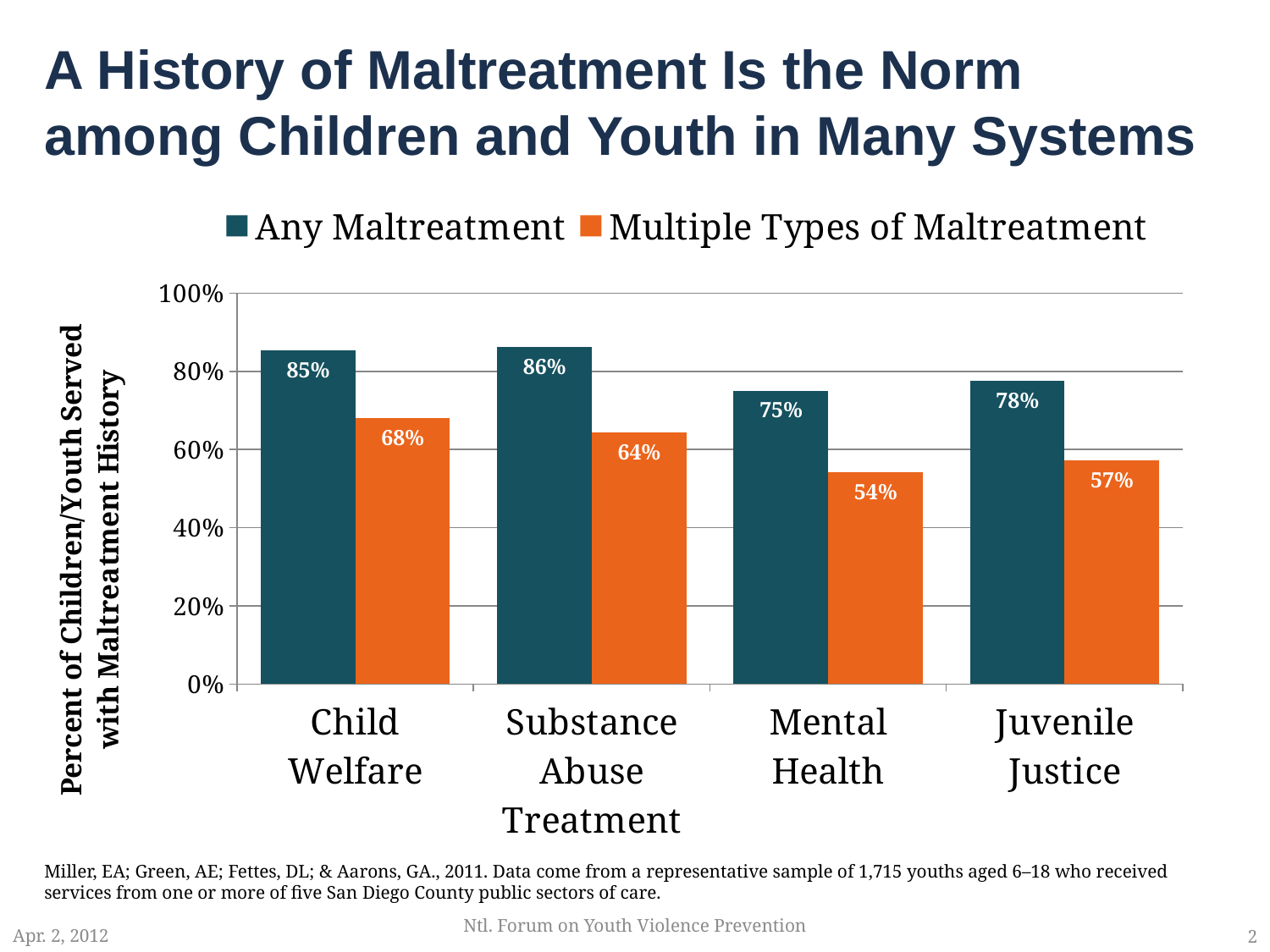
What kind of chart is shown on the slide? Bar chart Which is larger: Multiple Types of Maltreatment in Child Welfare or in Juvenile Justice? Child Welfare Which category has the highest value for Any Maltreatment? Substance Abuse Treatment What is the label of the y axis? Percent of Children/Youth Served with Maltreatment History What is the difference between Any Maltreatment and Multiple Types of Maltreatment in Substance Abuse Treatment? 22% What is the value for Multiple Types of Maltreatment in Mental Health? 54% Is the value for Any Maltreatment in Mental Health greater or less than 60%? greater What is the value for Multiple Types of Maltreatment in Juvenile Justice? 57% Which category has the lowest value for Multiple Types of Maltreatment? Mental Health What is the value for Any Maltreatment in Child Welfare? 85% How many series does the legend list? 2 How many categories are shown on the x axis? 4